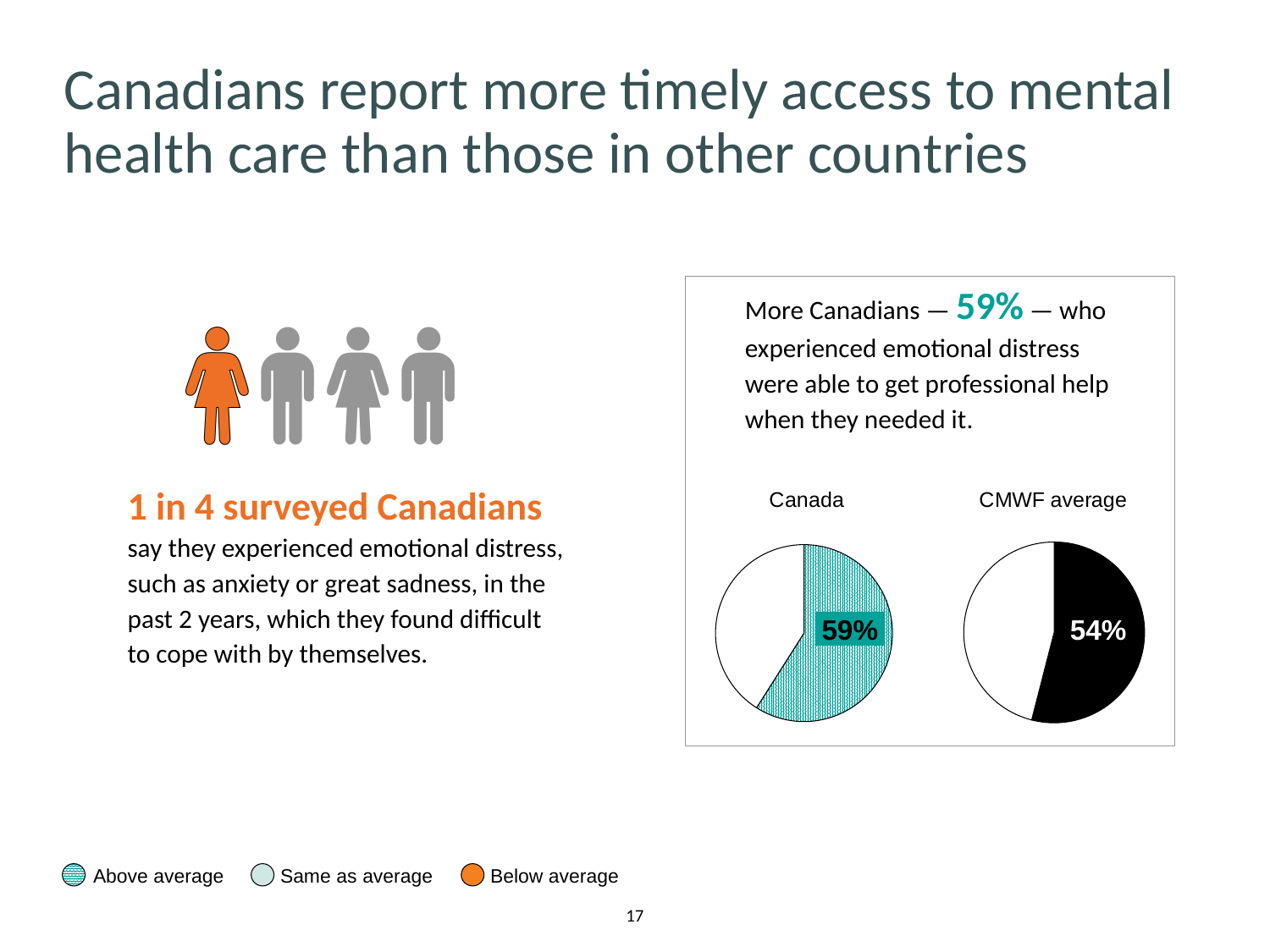
In the Canada pie chart, what share of Canadians who experienced emotional distress were able to get professional help when they needed it? 59% What is the difference in percentage points between the Canada value (59%) and the CMWF average value (54%)? 5 percentage points How many pie charts are shown on the slide? 2 What kind of charts are used to show the Canada and CMWF average values? Pie charts What is the label of the pie chart on the right inside the boxed panel? CMWF average Is the highlighted share in the Canada pie chart greater or less than 50%? greater Is the highlighted share in the CMWF average pie chart greater or less than 60%? less In the CMWF average pie chart, what percentage is shown for the highlighted slice? 54% According to the legend at the bottom of the slide, what does the teal striped pattern used in the Canada pie chart indicate? Above average What is the label of the pie chart on the left inside the boxed panel? Canada Which pie chart shows the larger highlighted share, Canada or CMWF average? Canada